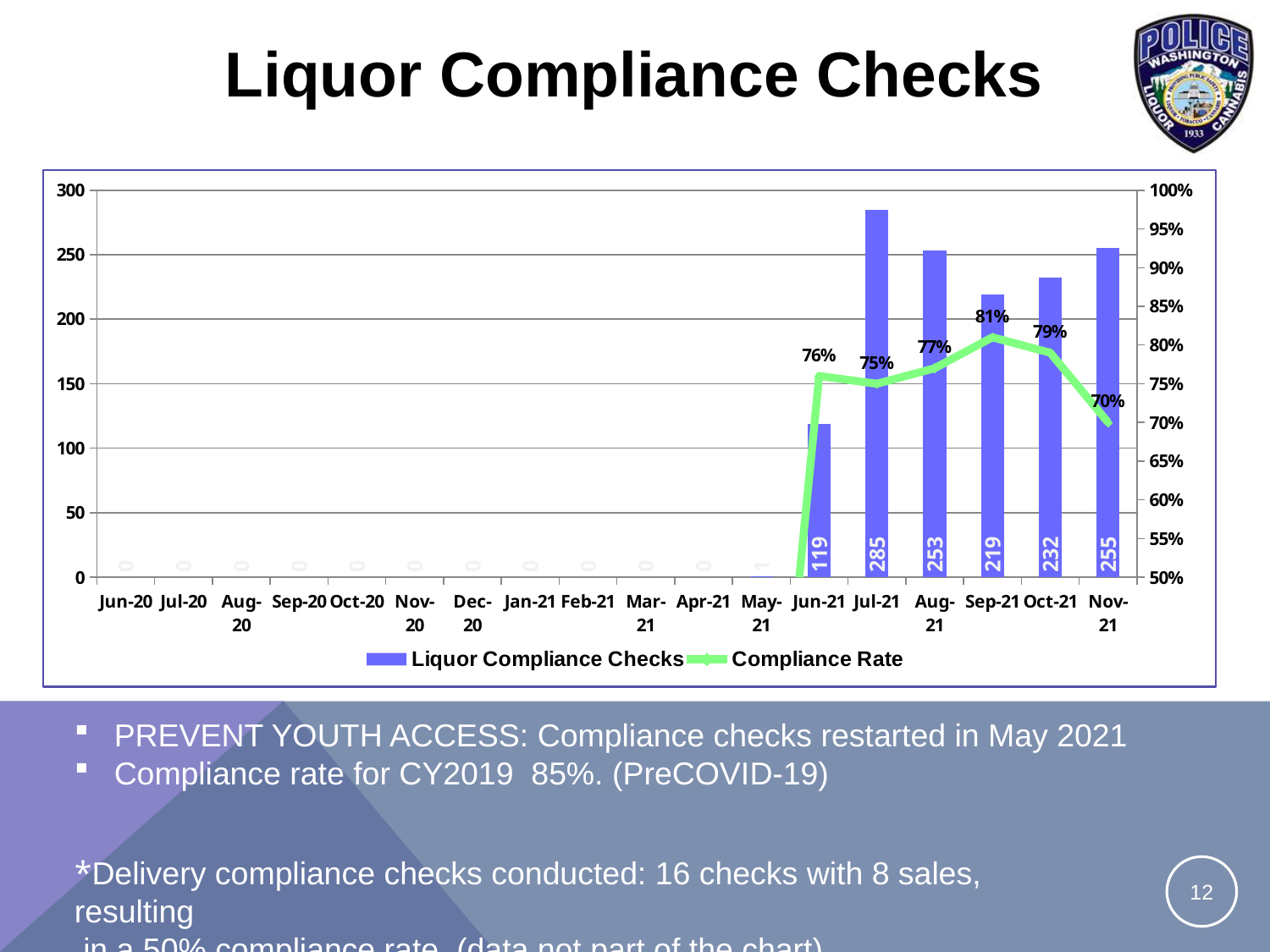
How many Liquor Compliance Checks were conducted in Jun-21? 119 Does the Compliance Rate rise or fall from Oct-21 to Nov-21? Fall Which month has the lowest Compliance Rate among the months with a plotted rate? Nov-21 Which month has the highest number of Liquor Compliance Checks? Jul-21 Which month had more Liquor Compliance Checks, Aug-21 or Oct-21? Aug-21 What is the title of the chart on the slide? Liquor Compliance Checks How many Liquor Compliance Checks were conducted in Jul-21? 285 What was the Compliance Rate in Sep-21? 81% How many series does the legend list? 2 What kind of chart is shown on the slide? Combined bar and line chart What is the difference in Liquor Compliance Checks between Jul-21 and Jun-21? 166 Is the number of Liquor Compliance Checks in Nov-21 greater or less than 250? greater